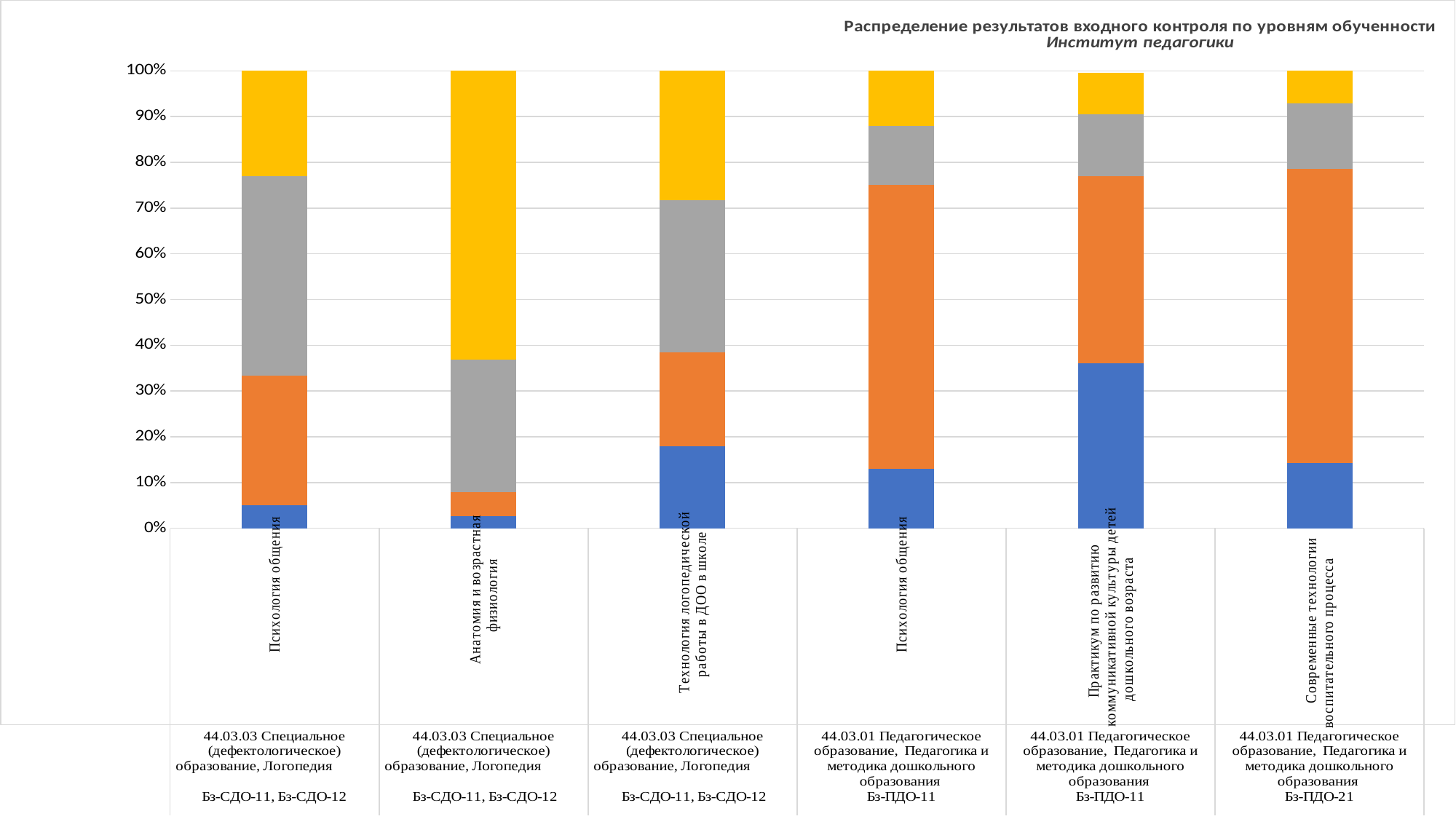
How many bars (disciplines) are plotted in the chart? 6 Is the orange segment for 'Современные технологии воспитательного процесса' greater or less than 60%? greater What kind of chart is shown on the slide? stacked bar chart Which institute is named in the chart's subtitle? Институт педагогики Is the blue segment for 'Практикум по развитию коммуникативной культуры детей дошкольного возраста' greater or less than 30%? greater Which discipline has the largest blue segment? Практикум по развитию коммуникативной культуры детей дошкольного возраста What is the title of the chart? Распределение результатов входного контроля по уровням обученности Which is larger: the yellow segment for 'Психология общения' (Бз-СДО-11, Бз-СДО-12) or the yellow segment for 'Психология общения' (Бз-ПДО-11)? Психология общения (Бз-СДО-11, Бз-СДО-12) Which is larger: the blue segment for 'Практикум по развитию коммуникативной культуры детей дошкольного возраста' or the blue segment for 'Технология логопедической работы в ДОО в школе'? Практикум по развитию коммуникативной культуры детей дошкольного возраста Is the yellow segment for 'Анатомия и возрастная физиология' greater or less than 60%? greater Which discipline has the largest yellow segment? Анатомия и возрастная физиология